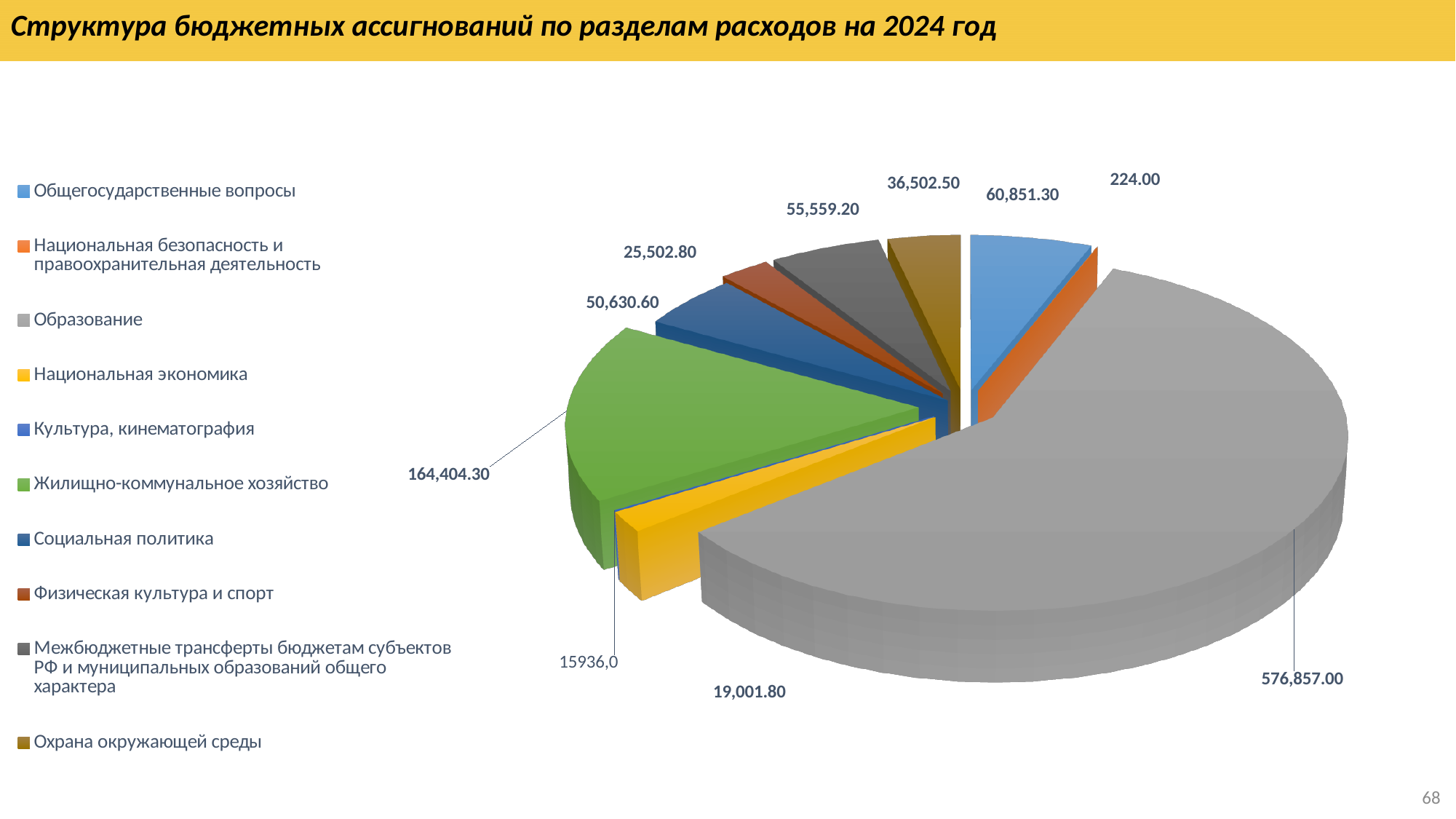
What is the value for Социальная политика? 50,630.60 How many categories does the legend of the pie chart list? 10 Which category has the largest slice of the pie? Образование What is the value for Жилищно-коммунальное хозяйство? 164,404.30 What is the title of the slide? Структура бюджетных ассигнований по разделам расходов на 2024 год What is the smallest value labelled on the pie chart? 224.00 What is the value for Охрана окружающей среды? 36,502.50 What is the difference between the values for Образование and Жилищно-коммунальное хозяйство? 412,452.70 Which is larger, Образование or Жилищно-коммунальное хозяйство? Образование What is the value for Образование? 576,857.00 What type of chart is shown on the slide? pie chart What is the value for Общегосударственные вопросы? 60,851.30